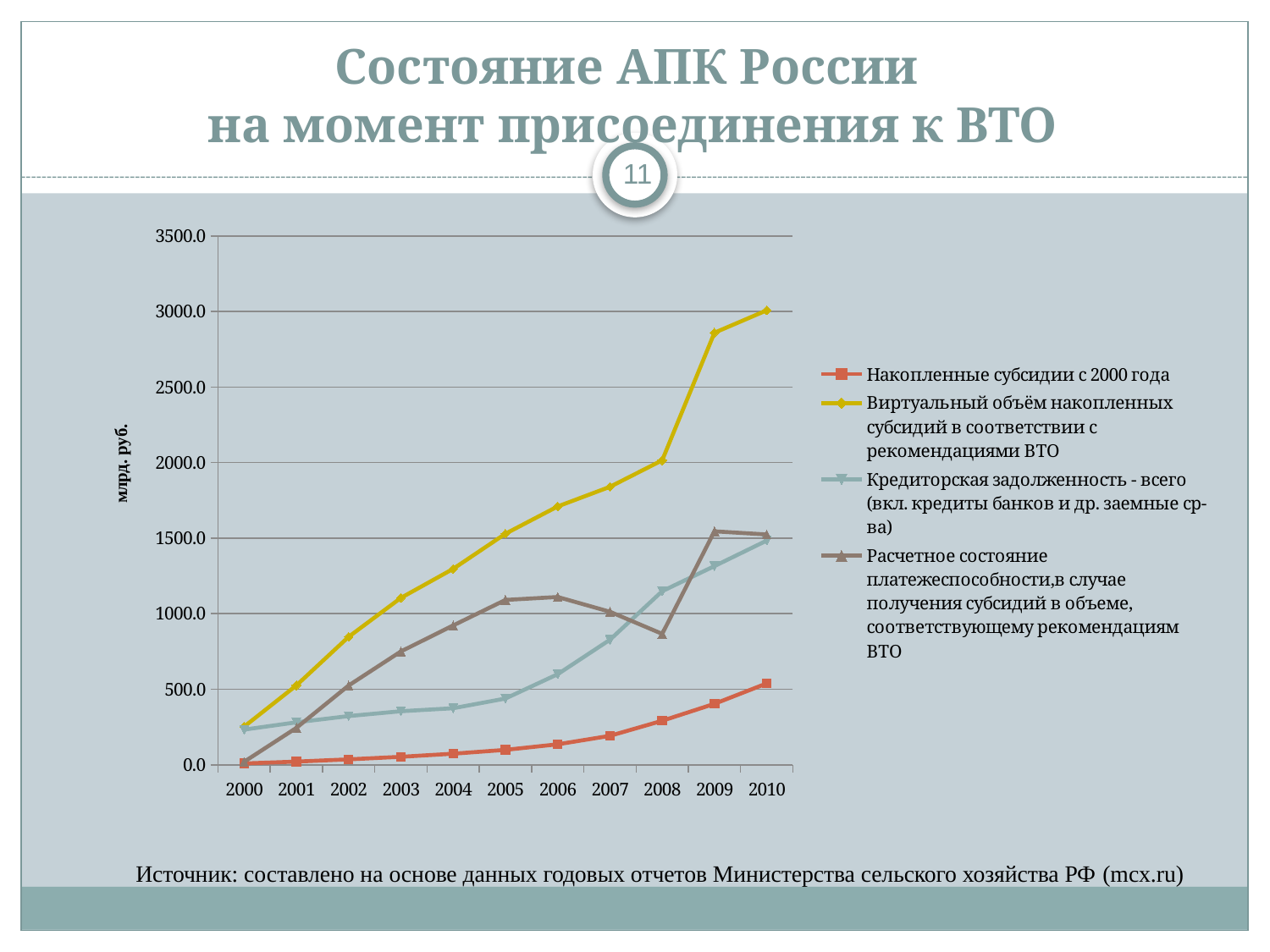
Which series has the lowest value in 2005? Накопленные субсидии с 2000 года Which series has the highest value in 2010? Виртуальный объём накопленных субсидий в соответствии с рекомендациями ВТО In 2008, which is higher: 'Кредиторская задолженность - всего' or 'Расчетное состояние платежеспособности'? Кредиторская задолженность - всего Does the 'Накопленные субсидии с 2000 года' series rise or fall from 2000 to 2010? rise Is the value for 'Виртуальный объём накопленных субсидий в соответствии с рекомендациями ВТО' in 2010 greater or less than 2500? greater How many years are plotted along the x axis? 11 Is the value for 'Накопленные субсидии с 2000 года' in 2010 greater or less than 1000? less What is the label of the vertical axis? млрд. руб. How many series does the legend list? 4 Is the value for 'Расчетное состояние платежеспособности' in 2009 greater or less than 1000? greater What kind of chart is shown on the slide? line chart